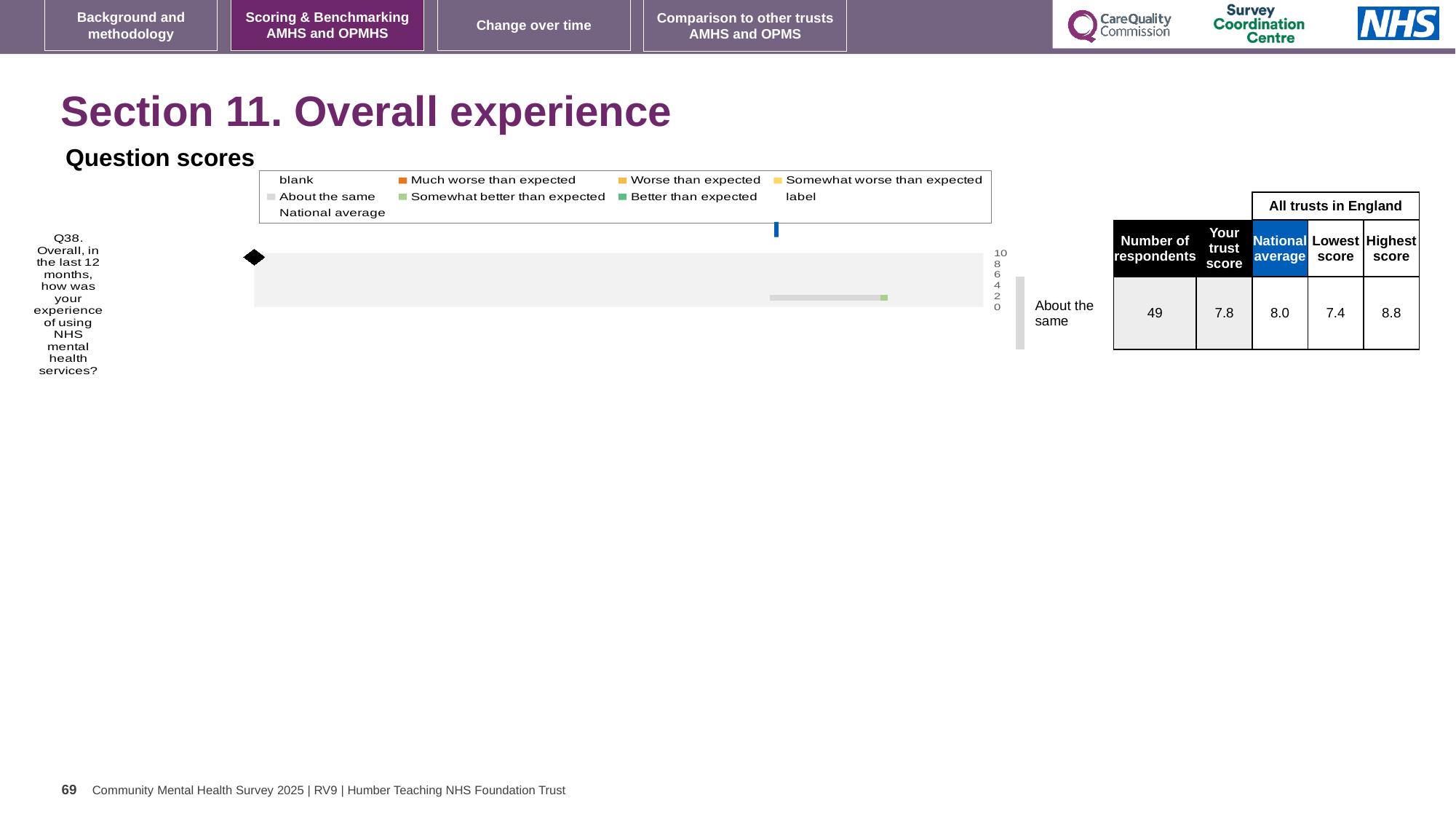
What benchmark category is shown for Q38 next to the chart? About the same Which question is plotted in the Question scores chart? Q38. Overall, in the last 12 months, how was your experience of using NHS mental health services? In the table beside the chart, how many respondents answered Q38? 49 What kind of chart is shown under 'Question scores'? bar chart In the table beside the chart, what is the highest score among all trusts in England for Q38? 8.8 How many questions (categories) are plotted in the Question scores chart? 1 In the table beside the chart, what is the national average for Q38? 8.0 Which is larger for Q38, the trust's score or the national average? the national average What is the maximum value shown on the chart's score axis? 10 What is the difference between the highest and lowest scores among all trusts in England for Q38? 1.4 In the table beside the chart, what is the lowest score among all trusts in England for Q38? 7.4 In the table beside the chart, what is the trust's score for Q38? 7.8